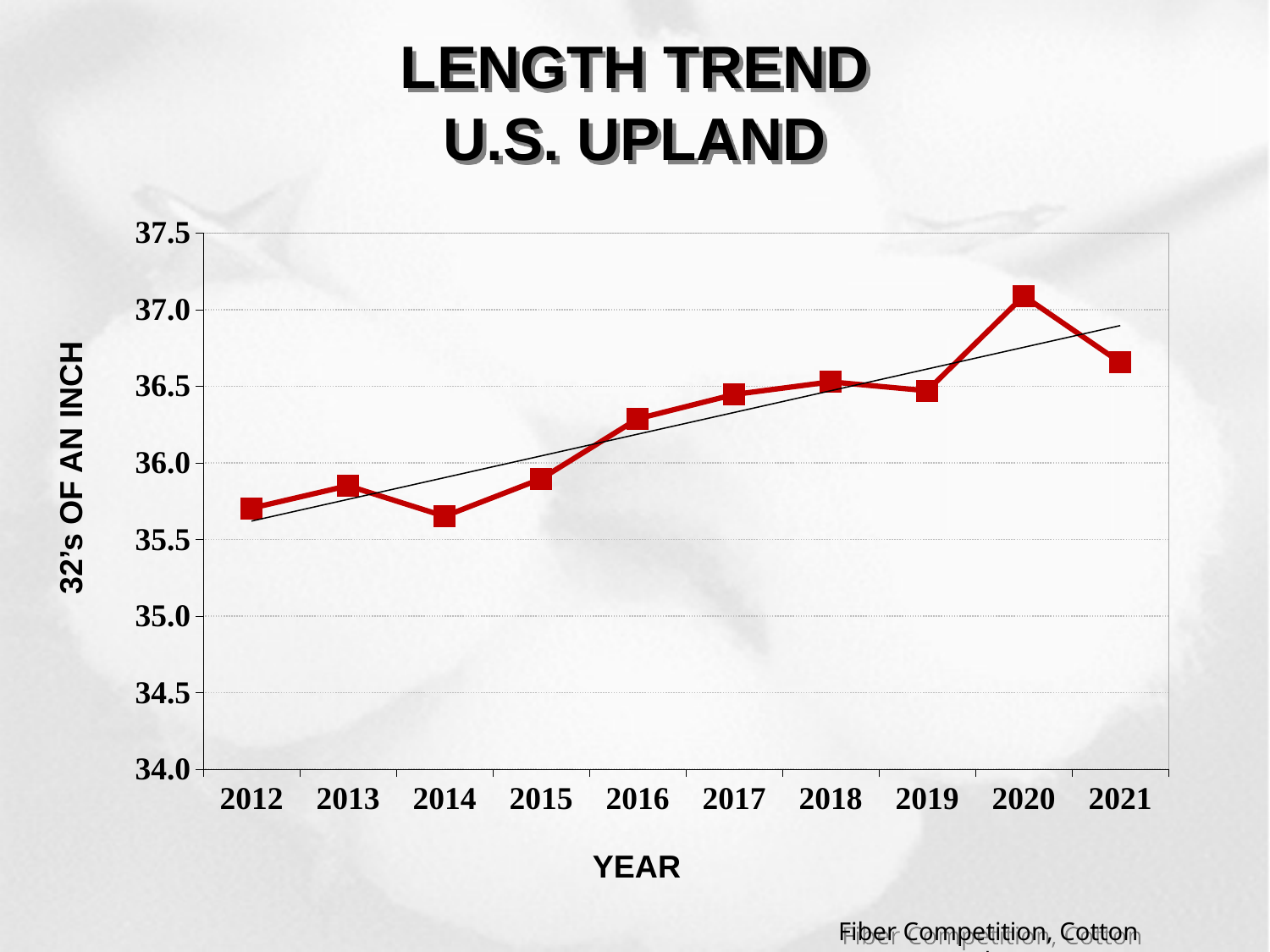
Do the values generally rise or fall from 2012 to 2021? rise How many years are plotted on the x axis? 10 Which year has the highest length value? 2020 Which year has the lowest length value? 2014 What kind of chart is shown on the slide? line chart Which year has the larger value, 2012 or 2021? 2021 What is the label on the vertical axis? 32's OF AN INCH Is the value for 2021 greater or less than 36.5? greater Which year has the larger value, 2020 or 2021? 2020 Is the value for 2014 greater or less than 36.0? less Is the value for 2020 greater or less than 37.0? greater